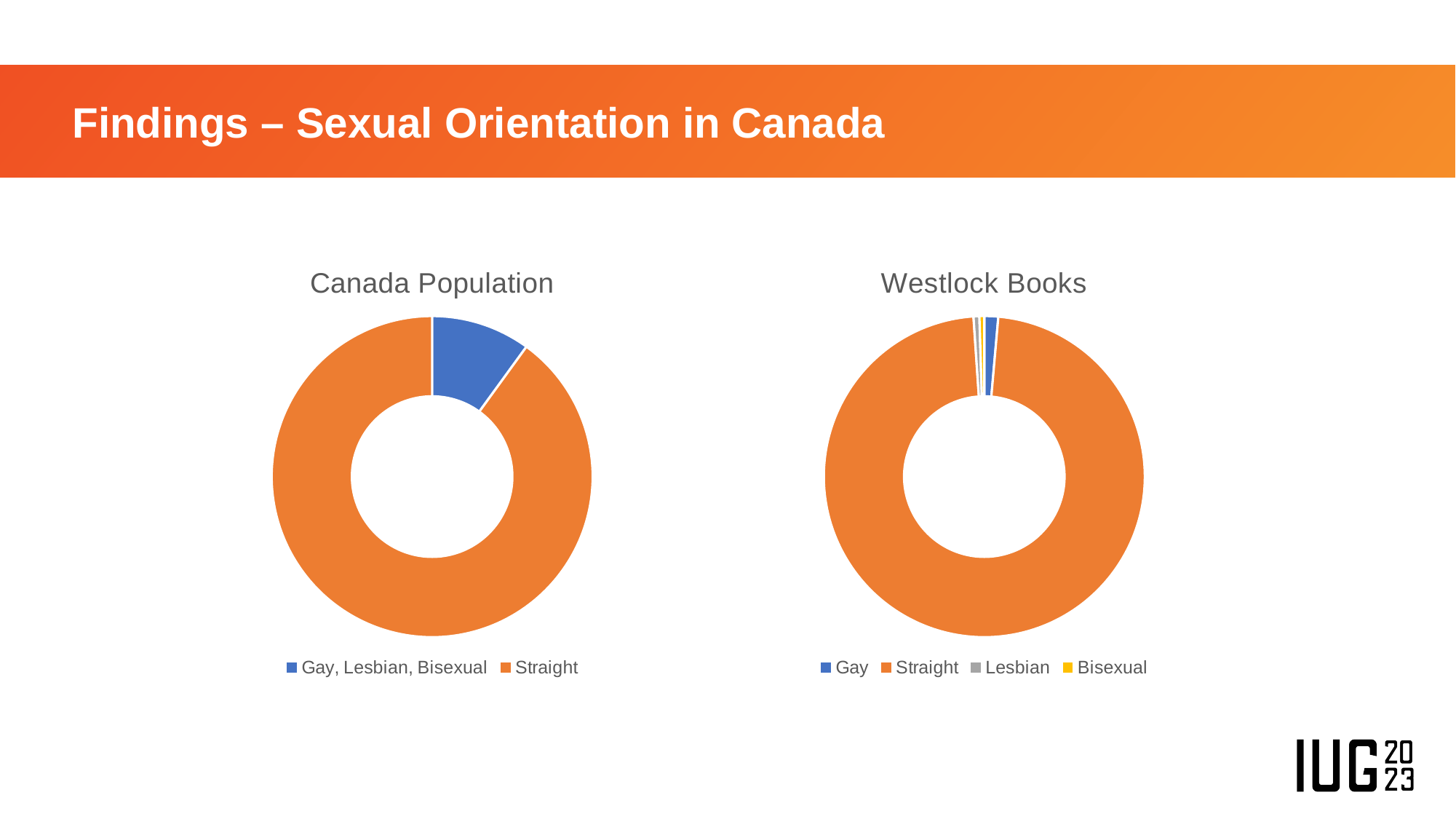
In the "Westlock Books" chart, which is larger: the share for Straight or the share for Gay? Straight In the "Canada Population" chart, which category has the largest share? Straight In the "Canada Population" chart, how many categories does the legend list? 2 What kind of chart is the "Westlock Books" chart? Doughnut chart In the "Westlock Books" chart, what colour represents the Bisexual category? Yellow In the "Canada Population" chart, which is larger: the share for Straight or the share for Gay, Lesbian, Bisexual? Straight What kind of chart is the "Canada Population" chart? Doughnut chart What is the title of the chart on the right side of the slide? Westlock Books In the "Westlock Books" chart, how many categories does the legend list? 4 In the "Canada Population" chart, which category has the smallest share? Gay, Lesbian, Bisexual In the "Westlock Books" chart, which category has the largest share? Straight